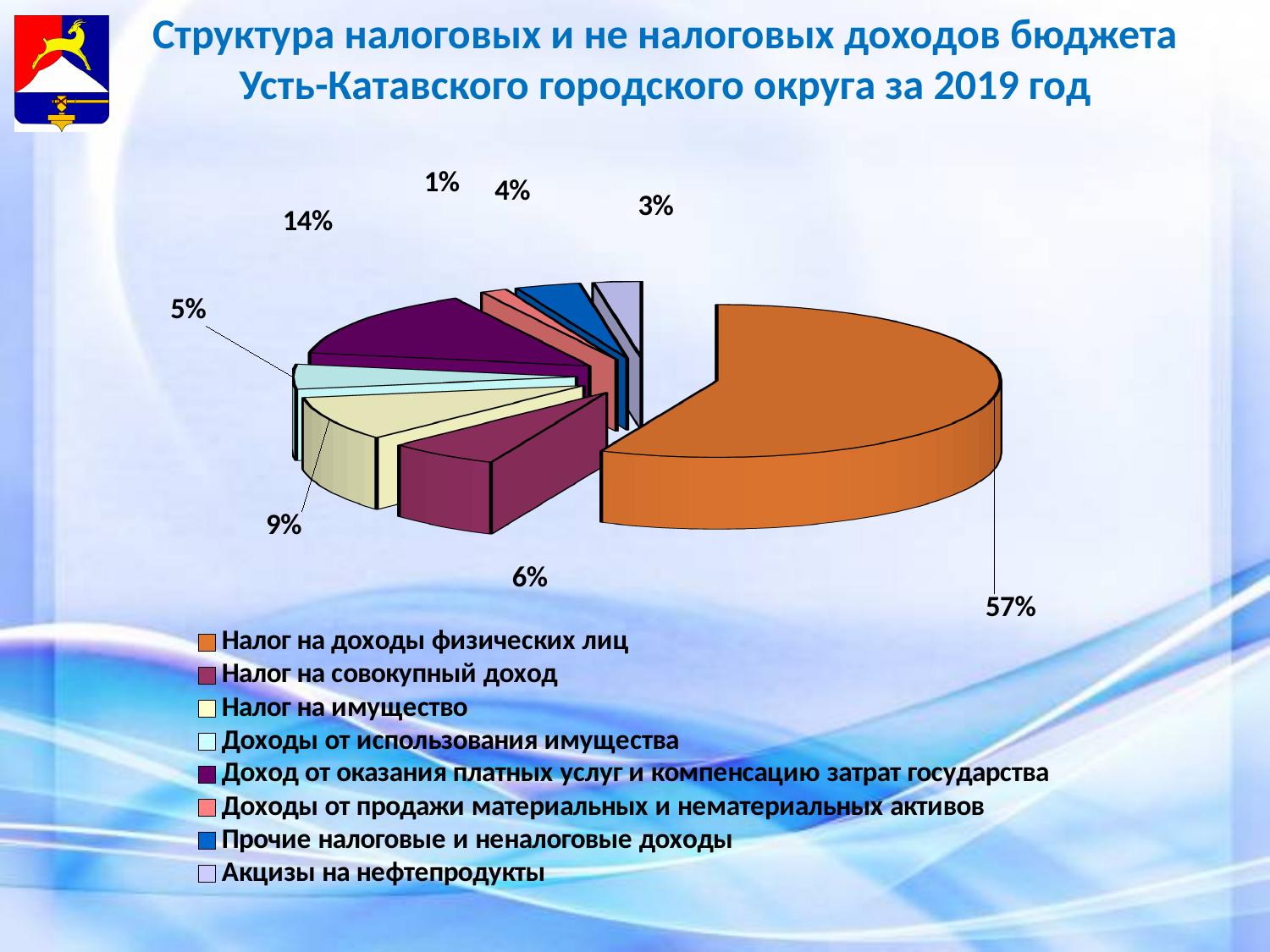
What type of chart is shown on the slide? Pie chart What share of the pie does "Налог на доходы физических лиц" have? 57% Which category has the largest share of the pie? Налог на доходы физических лиц What is the difference between the shares of "Налог на доходы физических лиц" and "Доход от оказания платных услуг и компенсацию затрат государства"? 43% What percentage is shown for "Налог на имущество"? 9% What colour is the slice for "Налог на доходы физических лиц"? Orange What percentage is shown for "Доходы от использования имущества"? 5% What percentage is shown for "Налог на совокупный доход"? 6% What is the smallest percentage shown on the pie chart? 1% What percentage is shown for "Доход от оказания платных услуг и компенсацию затрат государства"? 14% How many categories does the legend list? 8 Which is larger: the share of "Налог на имущество" or the share of "Налог на совокупный доход"? Налог на имущество